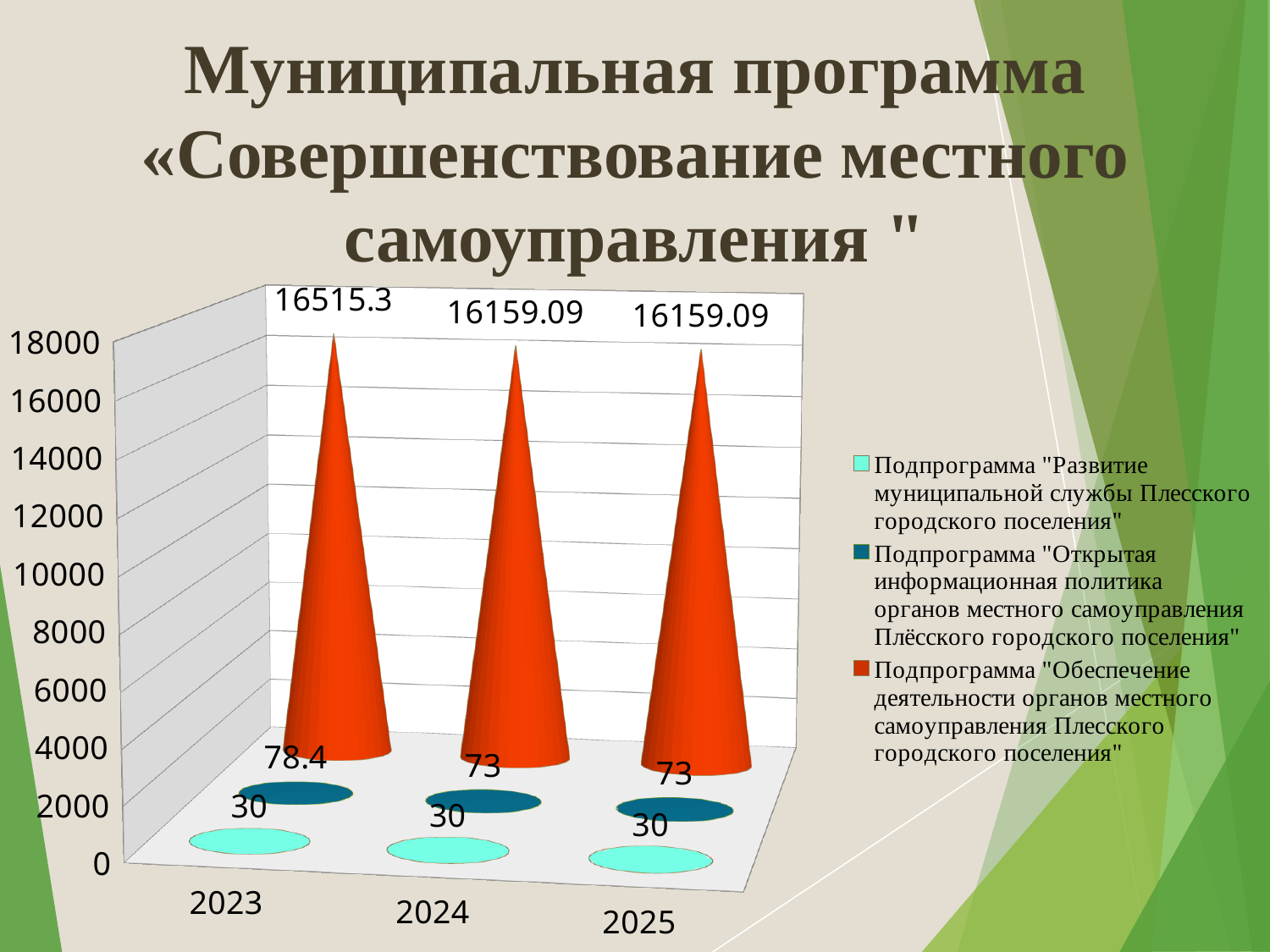
What is the value for 2024 for the subprogram "Обеспечение деятельности органов местного самоуправления Плесского городского поселения"? 16159.09 What is the difference between the 2023 and 2024 values for the subprogram "Обеспечение деятельности органов местного самоуправления Плесского городского поселения"? 356.21 How many series does the chart legend list? 3 What is the value for 2025 for the subprogram "Развитие муниципальной службы Плесского городского поселения"? 30 What is the value for 2023 for the subprogram "Обеспечение деятельности органов местного самоуправления Плесского городского поселения"? 16515.3 Which is larger: the 2023 value for the subprogram "Открытая информационная политика" or the 2023 value for the subprogram "Развитие муниципальной службы"? Открытая информационная политика Is the 2025 value for the subprogram "Обеспечение деятельности органов местного самоуправления" greater or less than 18000? less What is the value for 2023 for the subprogram "Открытая информационная политика органов местного самоуправления Плёсского городского поселения"? 78.4 In which year is the value for the subprogram "Обеспечение деятельности органов местного самоуправления Плесского городского поселения" highest? 2023 What is the difference between the 2023 and 2024 values for the subprogram "Открытая информационная политика органов местного самоуправления Плёсского городского поселения"? 5.4 How many years are shown on the x axis of the chart? 3 What kind of chart is shown on the slide? bar chart